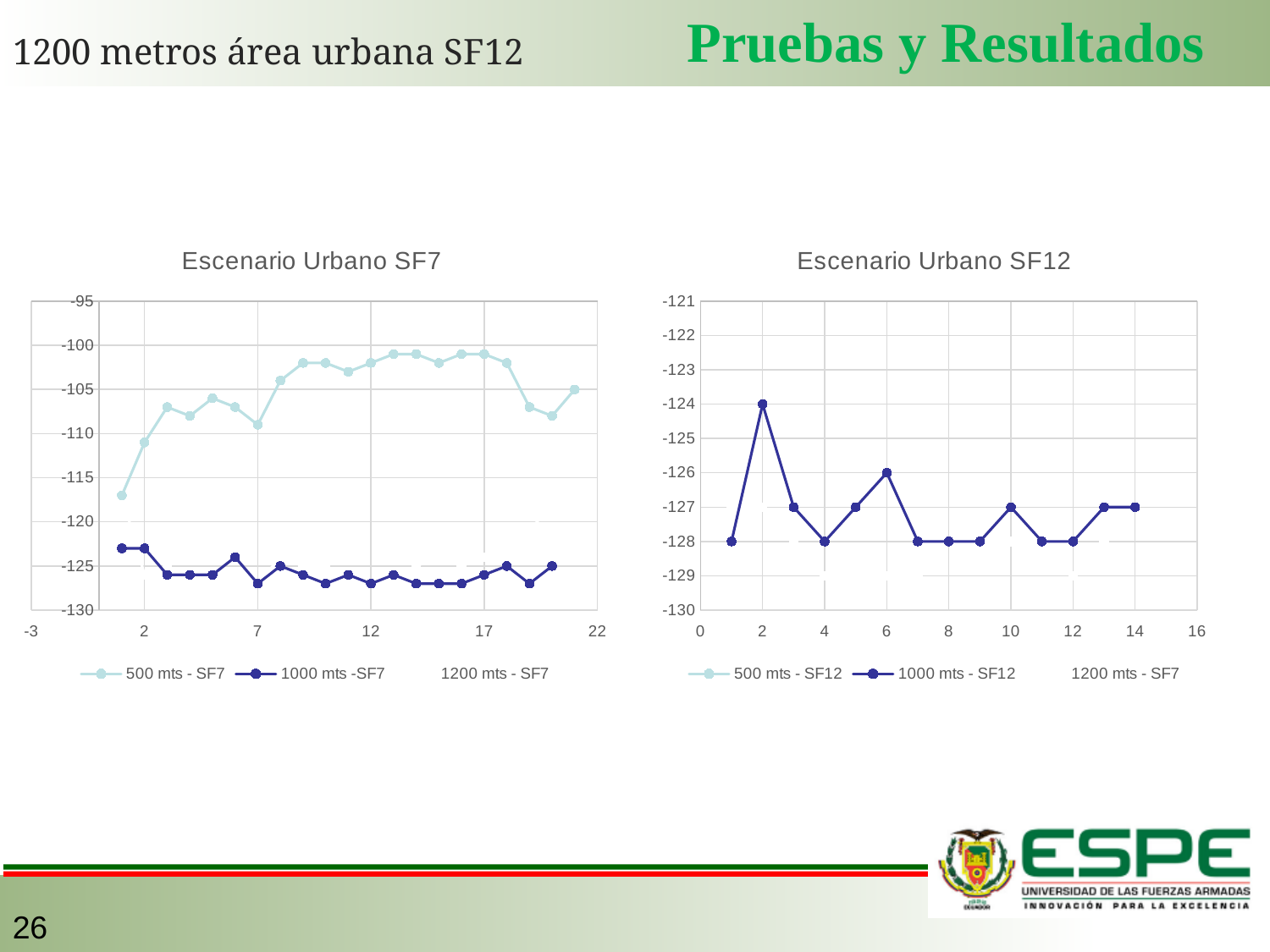
In the 'Escenario Urbano SF12' chart, what is the lowest value reached by the '1000 mts - SF12' series? -128 What kind of chart is the 'Escenario Urbano SF12' chart? line chart How many series does the legend of the 'Escenario Urbano SF12' chart list? 3 In the 'Escenario Urbano SF7' chart, which series has higher values overall, '500 mts - SF7' or '1000 mts -SF7'? 500 mts - SF7 In the 'Escenario Urbano SF7' chart, is the first value of the '500 mts - SF7' series greater or less than -115? less In the 'Escenario Urbano SF12' chart, what is the value of the '1000 mts - SF12' series at x = 2? -124 In the 'Escenario Urbano SF12' chart, what is the value of the '1000 mts - SF12' series at x = 6? -126 In the 'Escenario Urbano SF12' chart, how many data points does the '1000 mts - SF12' series have? 14 In the 'Escenario Urbano SF7' chart, is the first value of the '1000 mts -SF7' series greater or less than -125? greater In the 'Escenario Urbano SF12' chart, what is the difference between the '1000 mts - SF12' values at x = 2 and x = 6? 2 In the 'Escenario Urbano SF12' chart, at which x value does the '1000 mts - SF12' series reach its highest value? 2 In the 'Escenario Urbano SF12' chart, what is the value of the '1000 mts - SF12' series at x = 1? -128